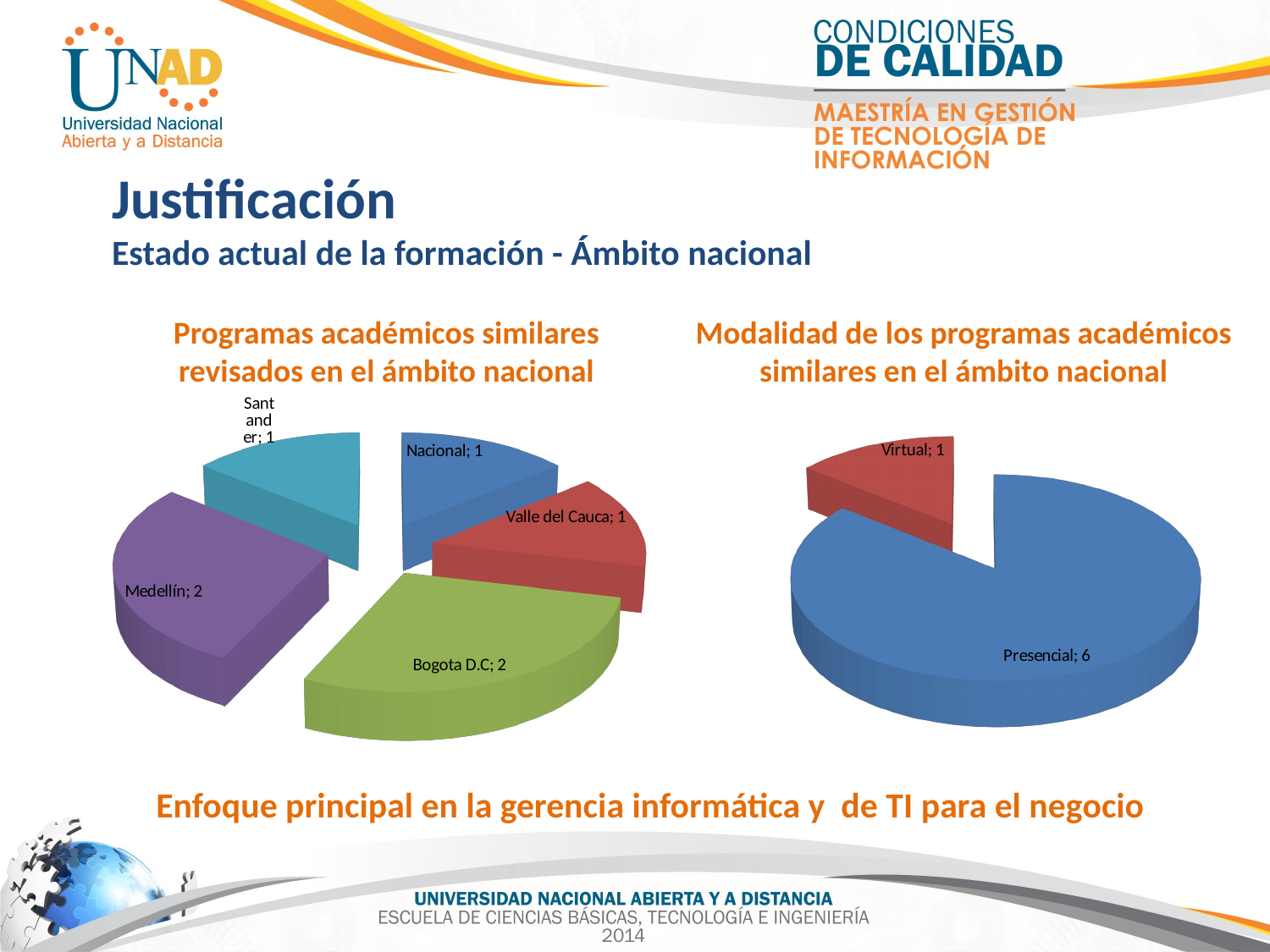
How many slices does the chart titled 'Programas académicos similares revisados en el ámbito nacional' have? 5 How many slices does the chart titled 'Modalidad de los programas académicos similares en el ámbito nacional' have? 2 In the chart titled 'Modalidad de los programas académicos similares en el ámbito nacional', what is the value for Presencial? 6 In the chart titled 'Modalidad de los programas académicos similares en el ámbito nacional', what is the value for Virtual? 1 In the chart titled 'Programas académicos similares revisados en el ámbito nacional', what is the value for Bogota D.C? 2 In the chart titled 'Modalidad de los programas académicos similares en el ámbito nacional', what is the difference between the Presencial and Virtual values? 5 In the chart titled 'Modalidad de los programas académicos similares en el ámbito nacional', which slice is the largest? Presencial In the chart titled 'Programas académicos similares revisados en el ámbito nacional', which is larger, Bogota D.C or Nacional? Bogota D.C In the chart titled 'Programas académicos similares revisados en el ámbito nacional', what is the value for Medellín? 2 In the chart titled 'Programas académicos similares revisados en el ámbito nacional', what is the value for Valle del Cauca? 1 In the chart titled 'Programas académicos similares revisados en el ámbito nacional', what colour is the Bogota D.C slice? Green What kind of chart is the one on the left of the slide? Pie chart